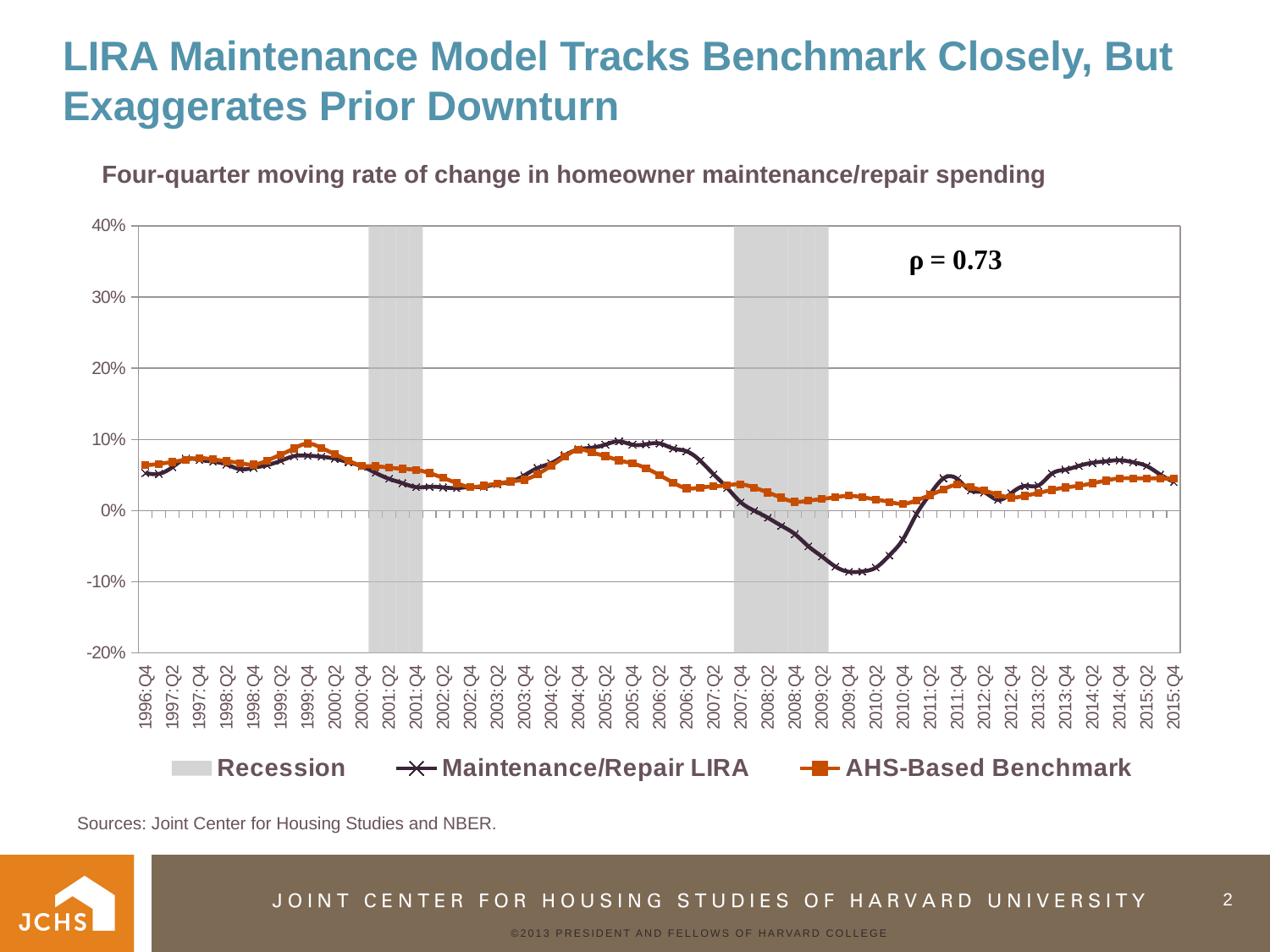
What kind of chart is shown on the slide? line chart Is the Maintenance/Repair LIRA value at 2005:Q2 greater or less than 0%? greater How many shaded recession periods are shown on the chart? 2 At 2005:Q2, which series is higher: Maintenance/Repair LIRA or AHS-Based Benchmark? Maintenance/Repair LIRA Is the AHS-Based Benchmark value at 2009:Q4 greater or less than 10%? less Which series reaches the lowest value anywhere on the chart? Maintenance/Repair LIRA Does the Maintenance/Repair LIRA series rise or fall between 2007:Q4 and 2009:Q4? fall What correlation value (ρ) is printed on the chart? ρ = 0.73 Is the AHS-Based Benchmark value at 2009:Q4 greater or less than 0%? greater How many entries does the chart legend list? 3 At 2009:Q4, which series is higher: Maintenance/Repair LIRA or AHS-Based Benchmark? AHS-Based Benchmark